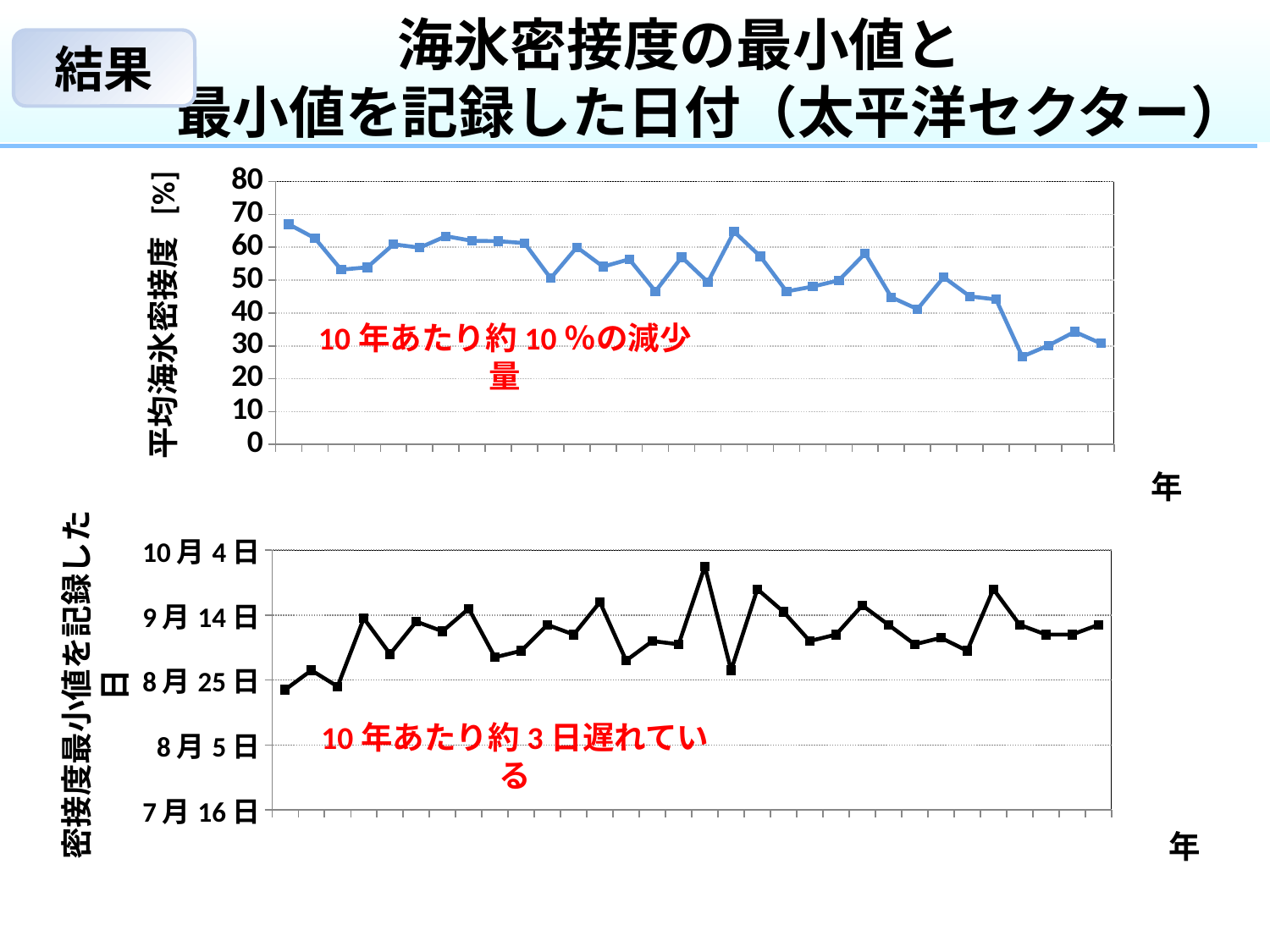
What kind of chart is the bottom chart (密接度最小値を記録した日)? line chart What is the maximum value shown on the y axis of the top chart? 80 How many data points are plotted in the top chart? 32 In the top chart, is the last (rightmost) value greater or less than 40? less In the top chart, which is larger, the first (leftmost) value or the last (rightmost) value? the first (leftmost) value In the bottom chart, is the first (leftmost) point earlier or later than 8月25日? earlier What is the red annotation text written on the top chart? 10年あたり約10%の減少量 What kind of chart is the top chart (平均海氷密接度)? line chart In the top chart, is the first (leftmost) value greater or less than 60? greater In the top chart, do the values generally rise or fall from left to right along the x axis? fall In the bottom chart, do the recorded dates generally get later or earlier from left to right along the x axis? later